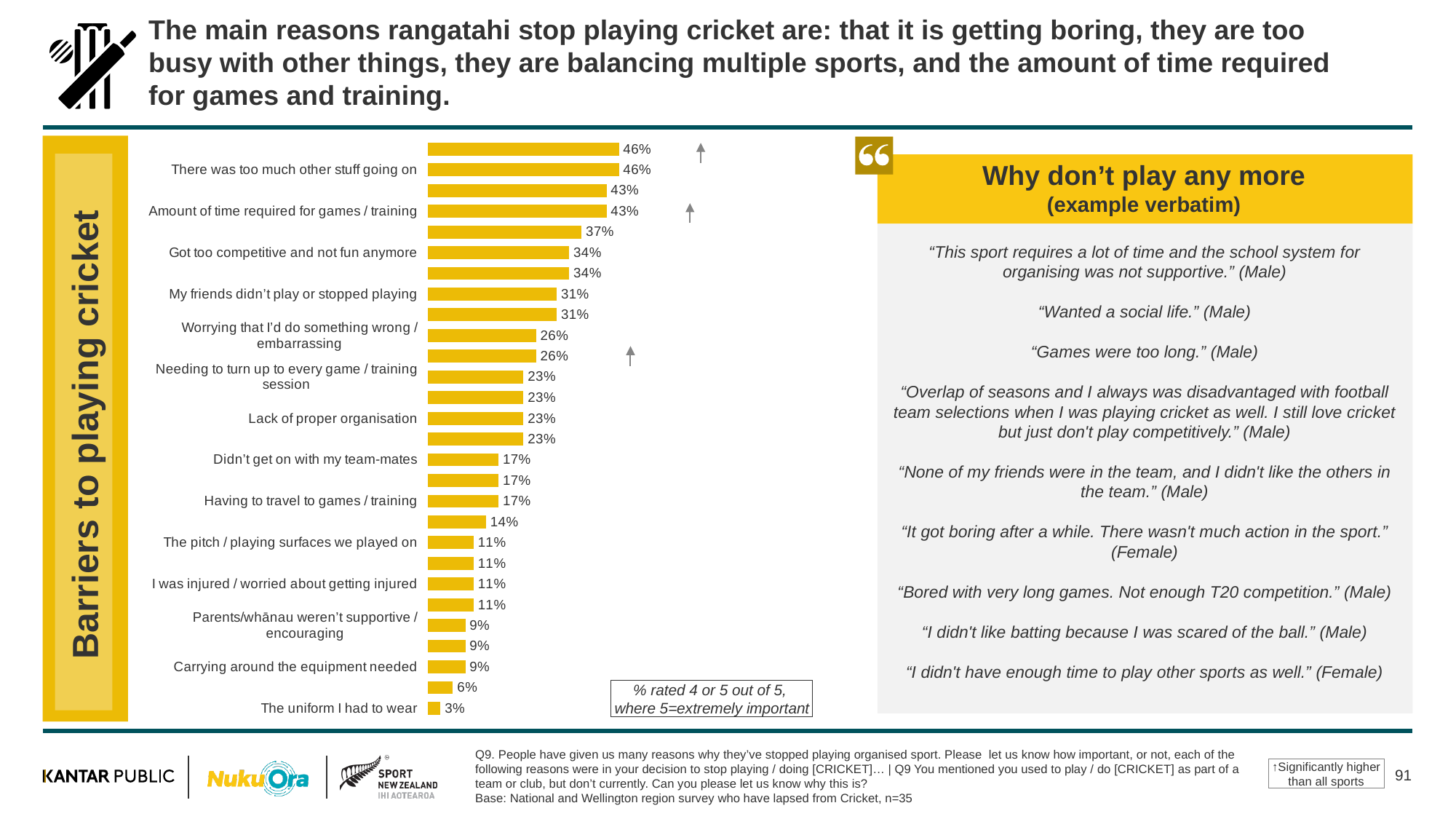
What type of chart is used to show the barriers to playing cricket? Bar chart What is the difference in percentage points between "Worrying that I'd do something wrong / embarrassing" and "Carrying around the equipment needed"? 17 Do the bar values increase or decrease going from the top of the chart to the bottom? Decrease What percentage is shown for "My friends didn't play or stopped playing"? 31% What percentage is shown for "The uniform I had to wear"? 3% What is the difference in percentage points between "There was too much other stuff going on" and "Amount of time required for games / training"? 3 What percentage is shown for "There was too much other stuff going on"? 46% What percentage is shown for "Amount of time required for games / training"? 43% Which labelled barrier has the lowest percentage? The uniform I had to wear What percentage is shown for "Got too competitive and not fun anymore"? 34% Which has a higher percentage: "Didn't get on with my team-mates" or "Parents/whānau weren't supportive / encouraging"? Didn't get on with my team-mates What is the title of the yellow box containing the example verbatim quotes? Why don't play any more (example verbatim)